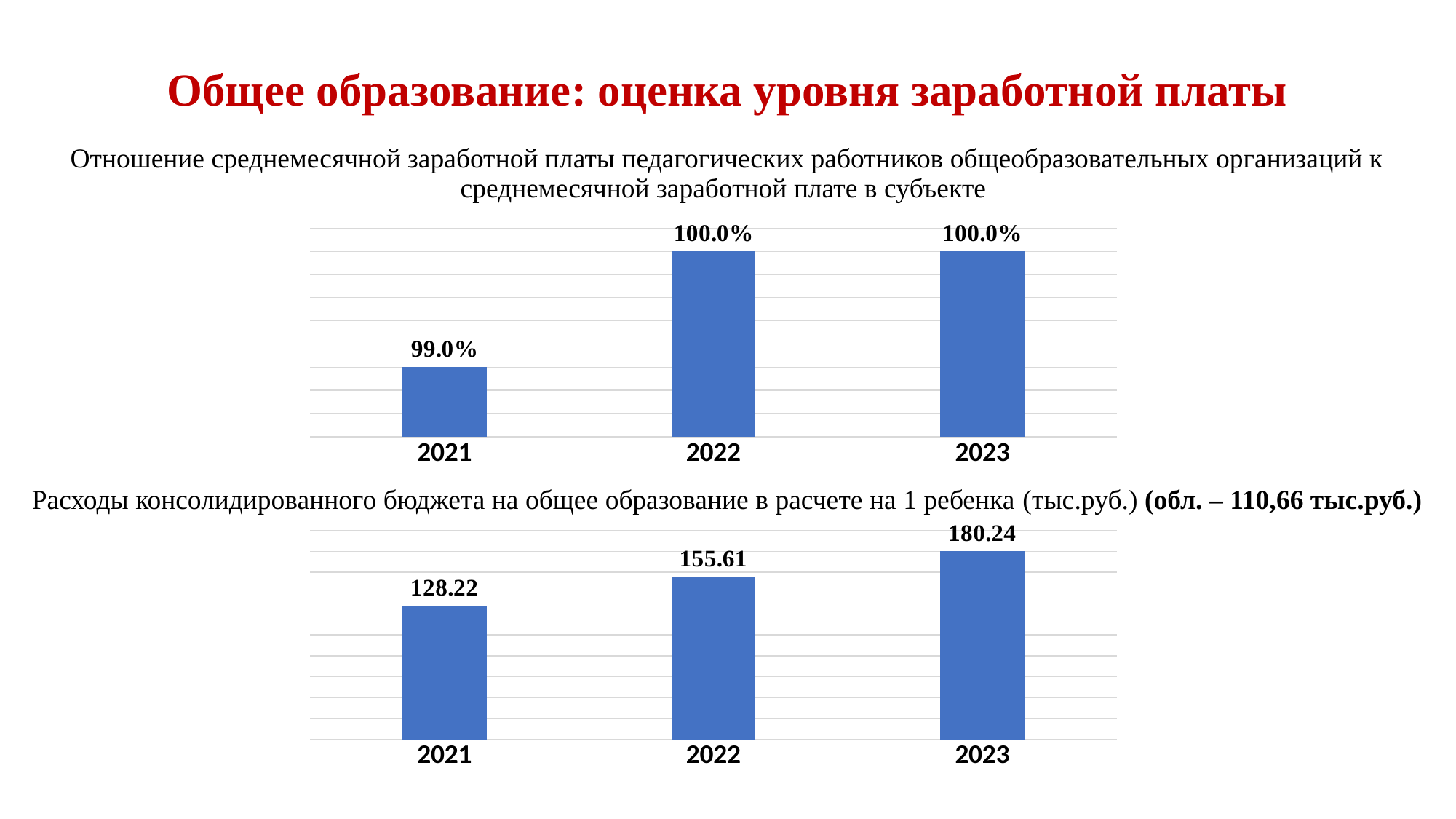
In the bottom chart, what is the difference between the 2023 value and the 2021 value? 52.02 In the bottom chart, what is the value for 2023? 180.24 In the bottom chart (consolidated budget expenses on general education per child), what is the value for 2022? 155.61 In the top chart, how many years are shown on the x axis? 3 In the top chart, what is the difference between the 2022 value and the 2021 value? 1.0% In the bottom chart, which year has the highest value? 2023 In the top chart, what is the value for 2023? 100.0% In the bottom chart, do the values rise or fall from 2021 to 2023? rise In the top chart (ratio of teachers' average monthly salary to the regional average), what is the value for 2021? 99.0% In the bottom chart, which is larger: the value for 2021 or the value for 2022? 2022 What type of chart is the bottom chart? bar chart In the top chart, which year has the lowest value? 2021